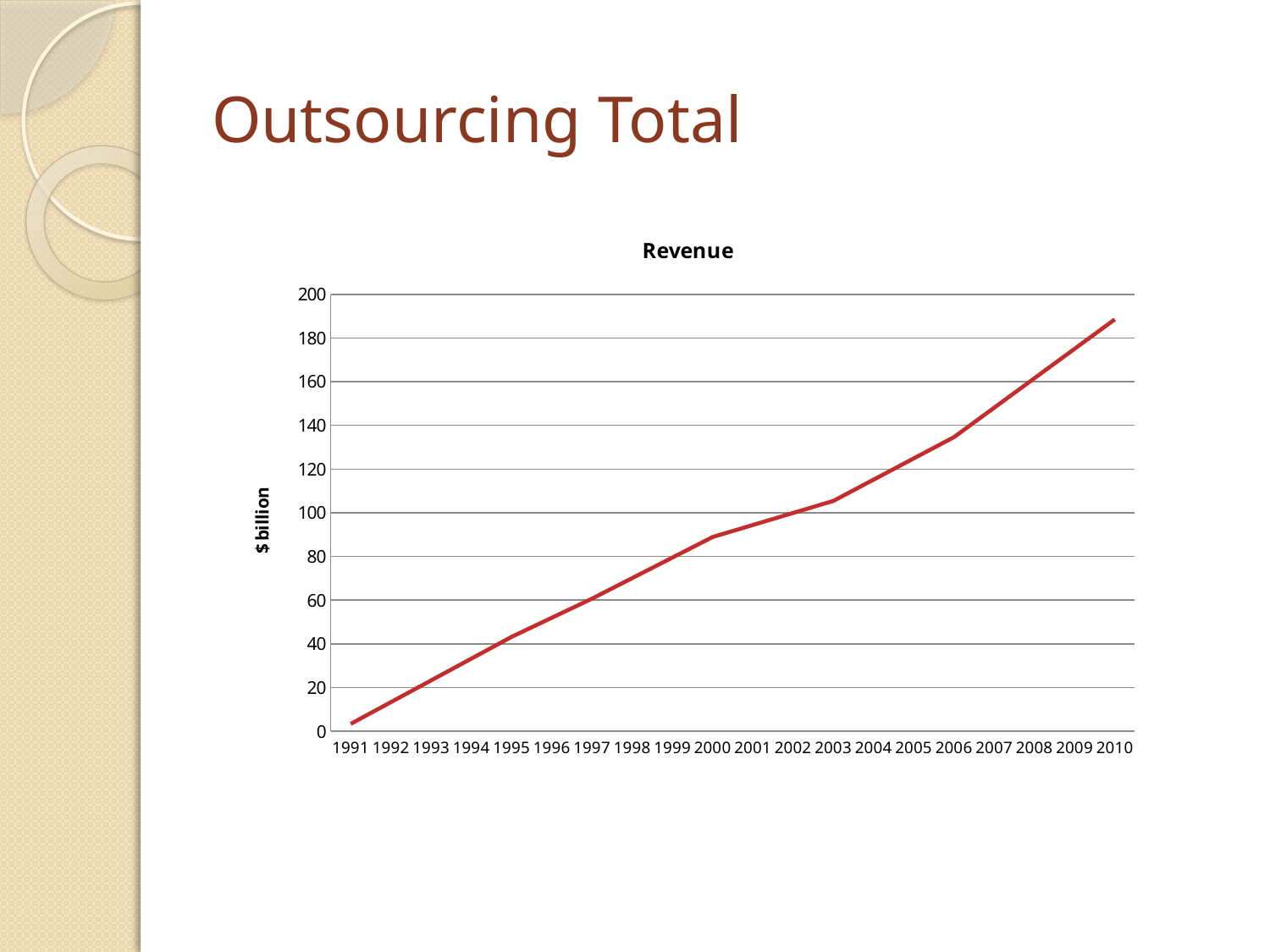
What kind of chart is shown on the slide? line chart Is the value for 2010 greater or less than 180? greater Which year has the highest revenue value? 2010 Is the value for 1991 greater or less than 20? less How many years are plotted along the x axis of the chart? 20 Which year has the lowest revenue value? 1991 What is the title of the chart? Revenue Is the value for 1995 greater or less than 60? less Do the revenue values rise or fall from 1991 to 2010? rise Which year has the larger revenue value, 2002 or 2008? 2008 What is the label on the vertical axis of the chart? $ billion